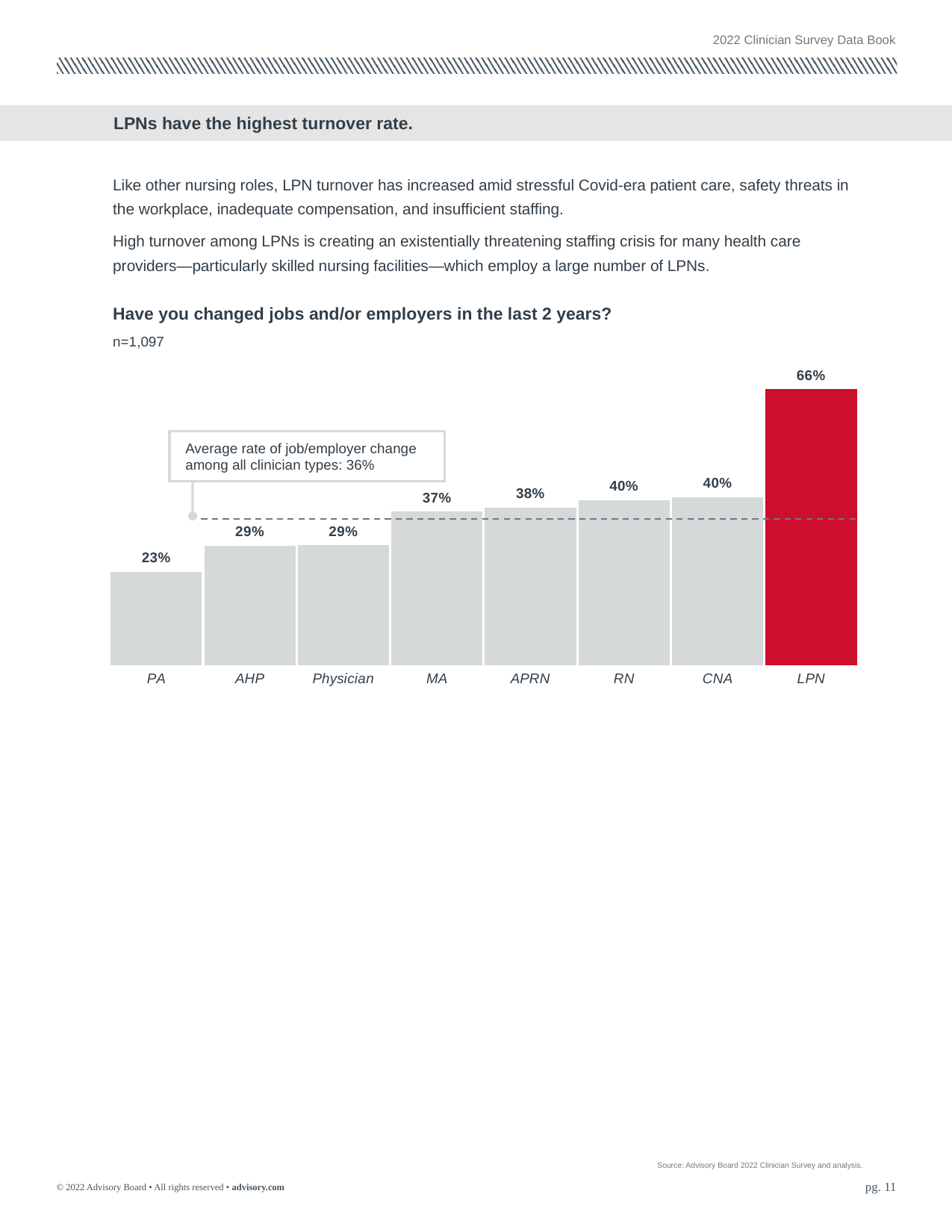
How many clinician types are shown on the chart? 8 What is the value shown for PA? 23% What is the difference between the LPN value and the CNA value? 26 percentage points Which bar is highlighted in red on the chart? LPN What percentage of LPNs changed jobs and/or employers in the last 2 years? 66% Which clinician type has the highest rate of job/employer change? LPN What is the value shown for MA? 37% Which is larger, the value for APRN or the value for Physician? APRN What kind of chart is shown on the slide? Bar chart What is the average rate of job/employer change among all clinician types, as noted on the chart? 36% Do the values rise or fall moving from left to right across the chart? Rise Which clinician type has the lowest rate of job/employer change? PA